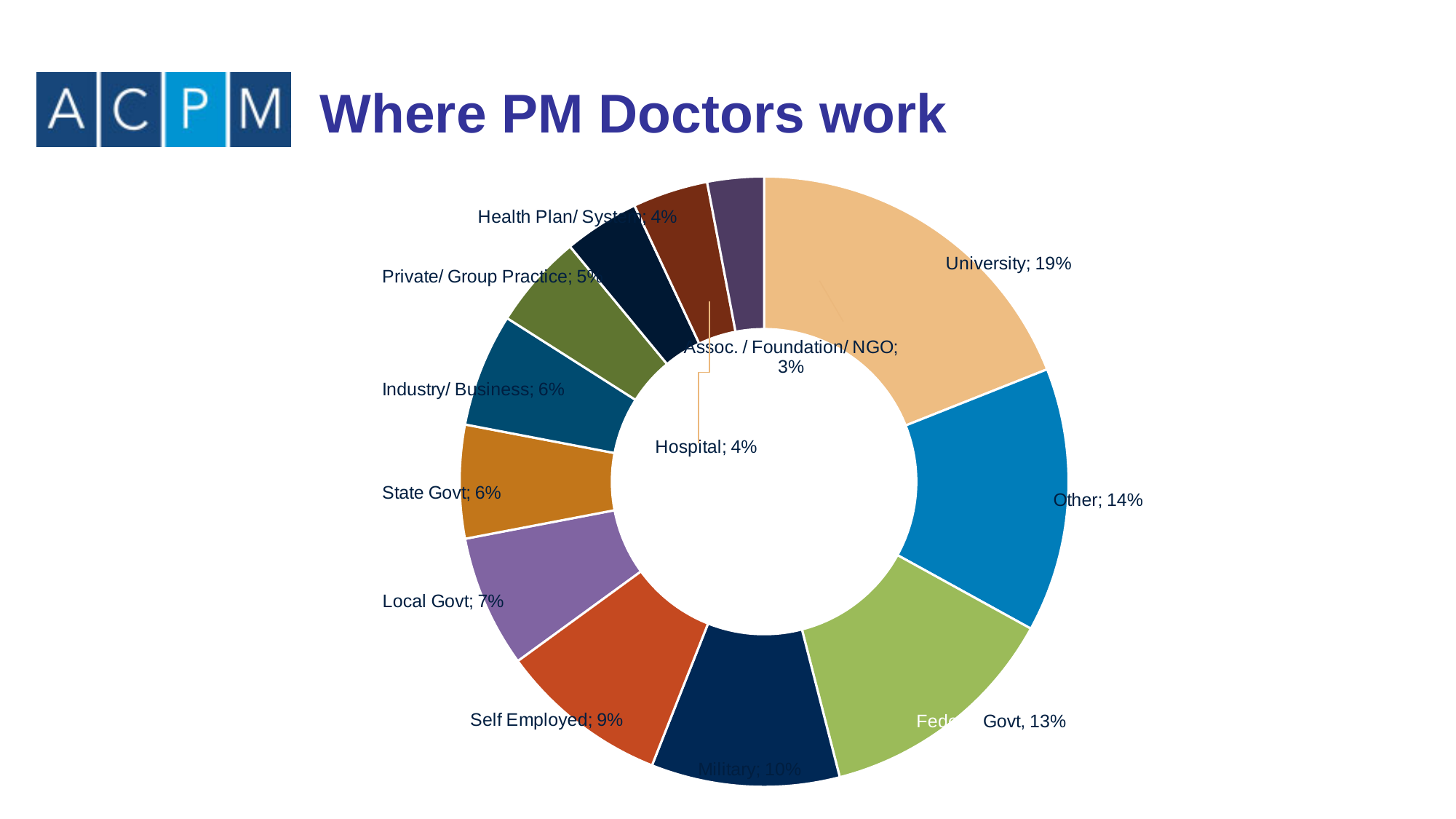
What percentage of PM doctors are Self Employed? 9% Which is larger, the share for Other or the share for Federal Govt? Other Which category has the largest share of PM doctors? University What is the title of the slide? Where PM Doctors work What percentage of PM doctors work in a Hospital? 4% Which category has the smallest share of PM doctors? Assoc. / Foundation/ NGO How many percentage points larger is the University share than the Military share? 9 How many categories are shown in the chart? 12 What kind of chart is shown on the slide? pie (doughnut) chart What percentage of PM doctors work at a University? 19% Which is larger, the share for Local Govt or the share for Self Employed? Self Employed What share of PM doctors work for the Federal Govt? 13%